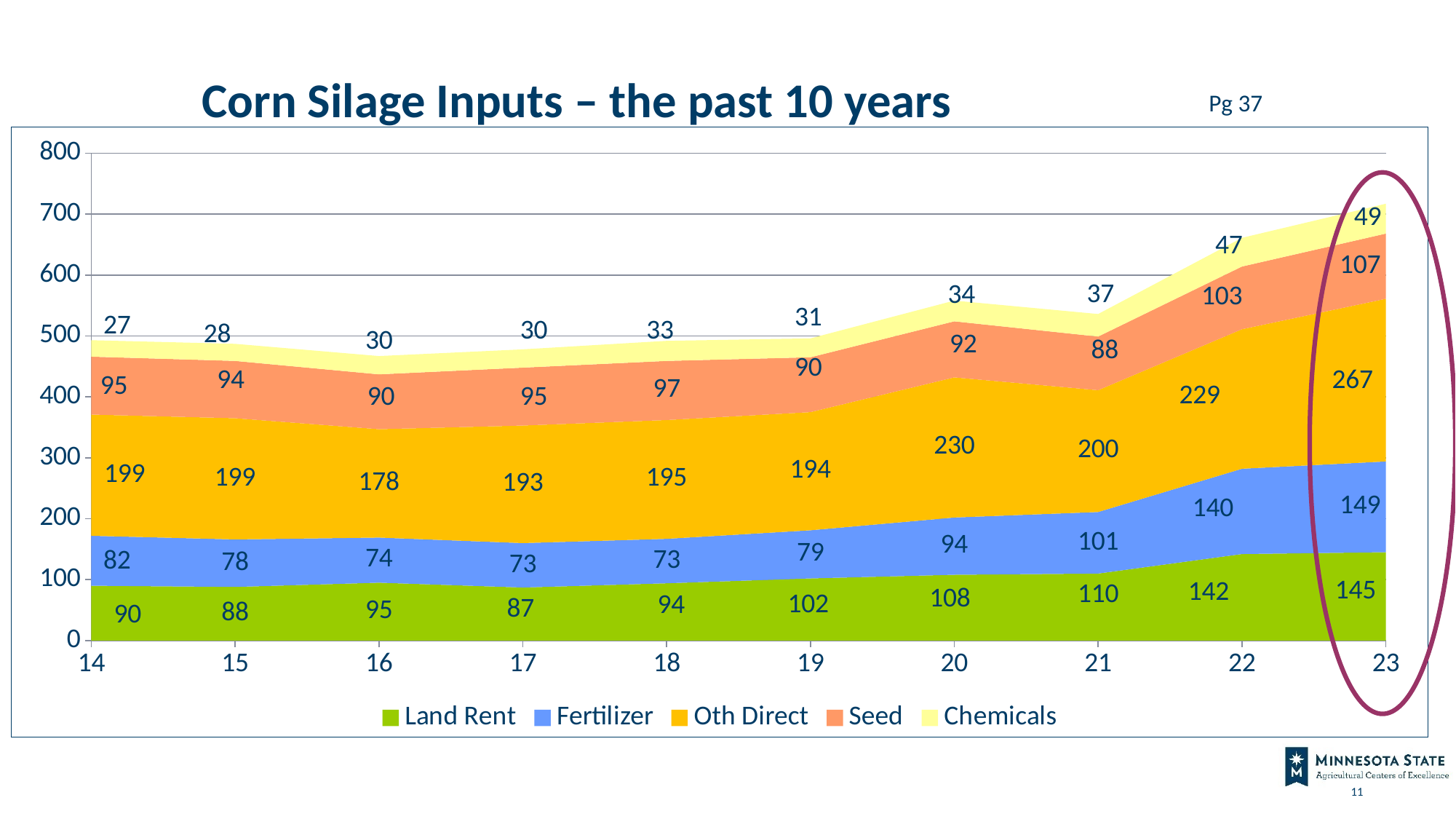
What is the Fertilizer value for year 17? 73 What is the Chemicals value for year 20? 34 What is the difference between the Fertilizer value in year 23 and in year 14? 67 In which year is Oth Direct lowest? 16 What is the total of all five inputs in year 23? 717 How many years are shown on the x axis? 10 Do the Chemicals values generally rise or fall from year 14 to year 23? Rise In which year is Land Rent highest? 23 Which is larger, the Seed value in year 22 or the Seed value in year 21? Year 22 How many series does the legend list? 5 What kind of chart is shown on the slide? Stacked area chart What is the Oth Direct value for year 23? 267